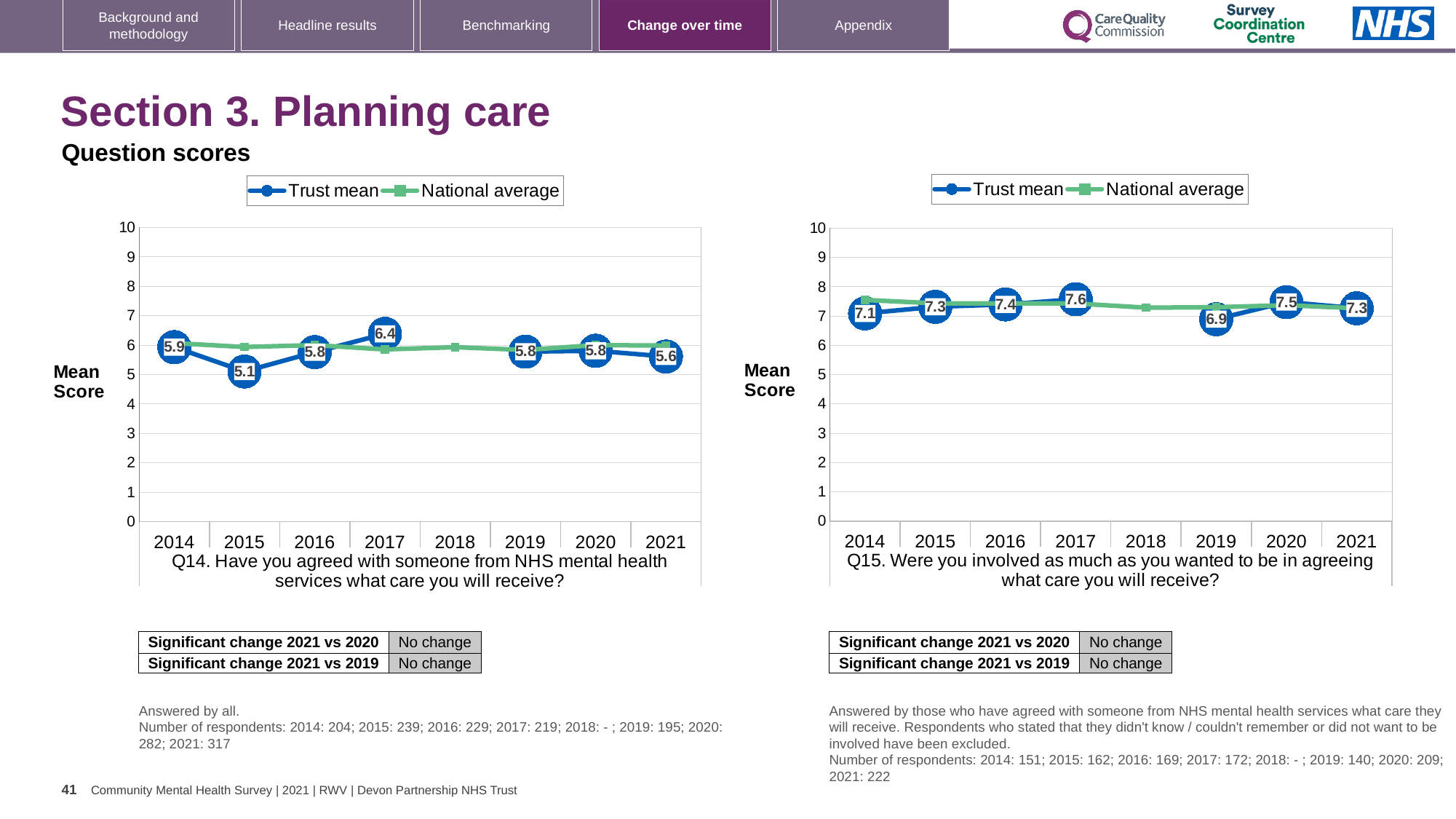
In the Q14 chart on the left, which year has the highest Trust mean? 2017 In the Q15 chart on the right, which year has the highest Trust mean? 2017 How many years are shown on the x axis of the Q15 chart on the right? 8 In the Q14 chart on the left, which year has the lowest Trust mean? 2015 In the Q15 chart on the right, what is the Trust mean for 2019? 6.9 How many series does the legend of the Q14 chart on the left list? 2 In the Q14 chart on the left, what is the Trust mean for 2017? 6.4 In the Q14 chart on the left, what is the difference between the Trust mean in 2017 and in 2015? 1.3 In the Q14 chart on the left, what is the Trust mean for 2015? 5.1 In the Q15 chart on the right, is the Trust mean for 2020 larger or smaller than for 2021? larger What kind of chart is the Q14 chart on the left? Line chart In the Q15 chart on the right, is the National average for 2014 greater or less than 7? greater